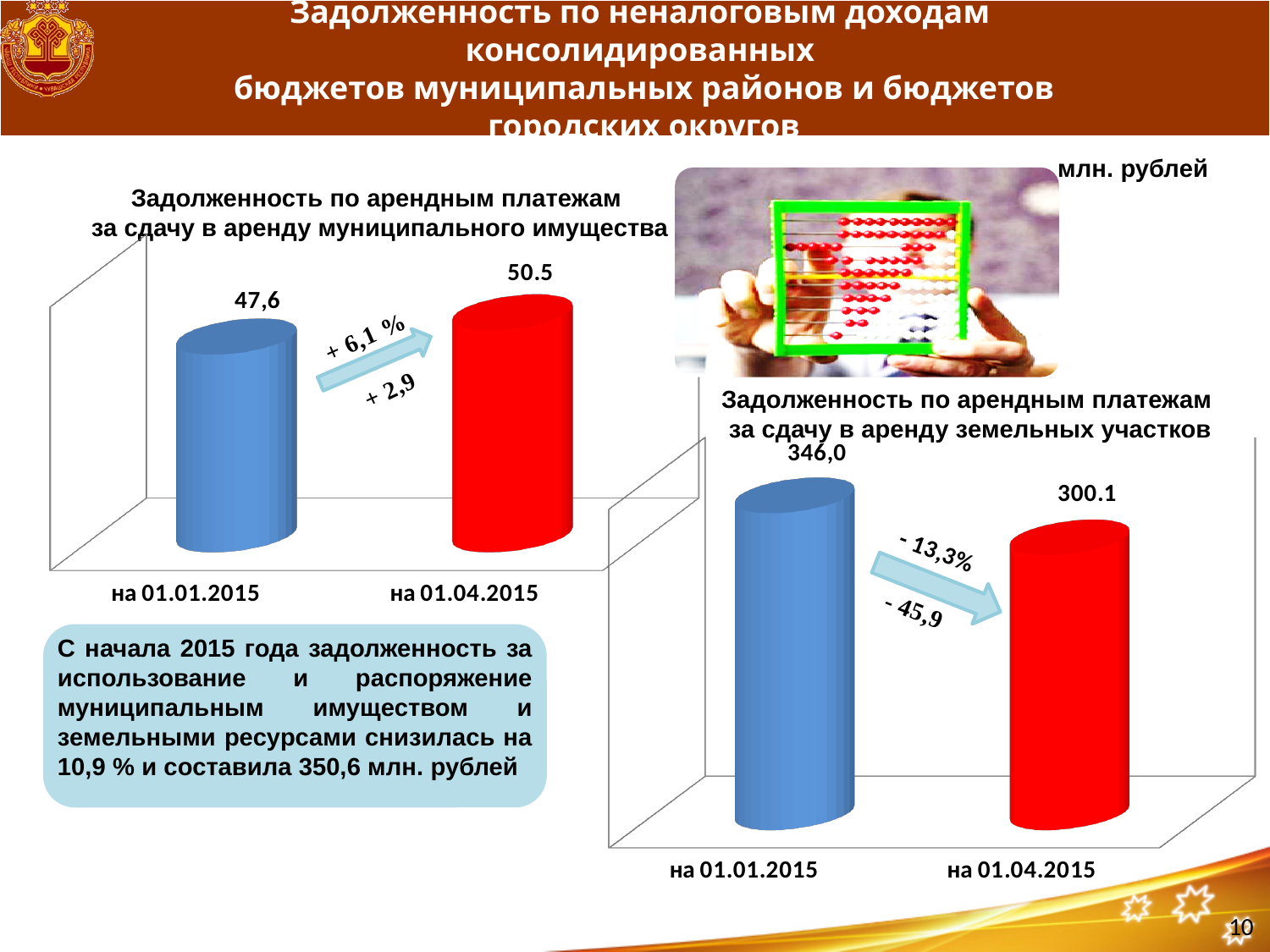
What type of chart is the left chart? bar chart In the left chart (Задолженность по арендным платежам за сдачу в аренду муниципального имущества), what is the value for на 01.04.2015? 50.5 In the right chart, by how much did the value decrease from на 01.01.2015 to на 01.04.2015? 45,9 In the right chart (Задолженность по арендным платежам за сдачу в аренду земельных участков), what is the value for на 01.04.2015? 300.1 Do the values in the left chart rise or fall from на 01.01.2015 to на 01.04.2015? rise In the right chart, which date has the lower value? на 01.04.2015 In the left chart (Задолженность по арендным платежам за сдачу в аренду муниципального имущества), what is the value for на 01.01.2015? 47,6 How many bars are shown in the right chart? 2 In the left chart, what is the difference between the value for на 01.04.2015 and the value for на 01.01.2015? 2,9 In the left chart, which date has the higher value? на 01.04.2015 In the right chart, is the value for на 01.01.2015 larger or smaller than the value for на 01.04.2015? larger In the right chart (Задолженность по арендным платежам за сдачу в аренду земельных участков), what is the value for на 01.01.2015? 346,0